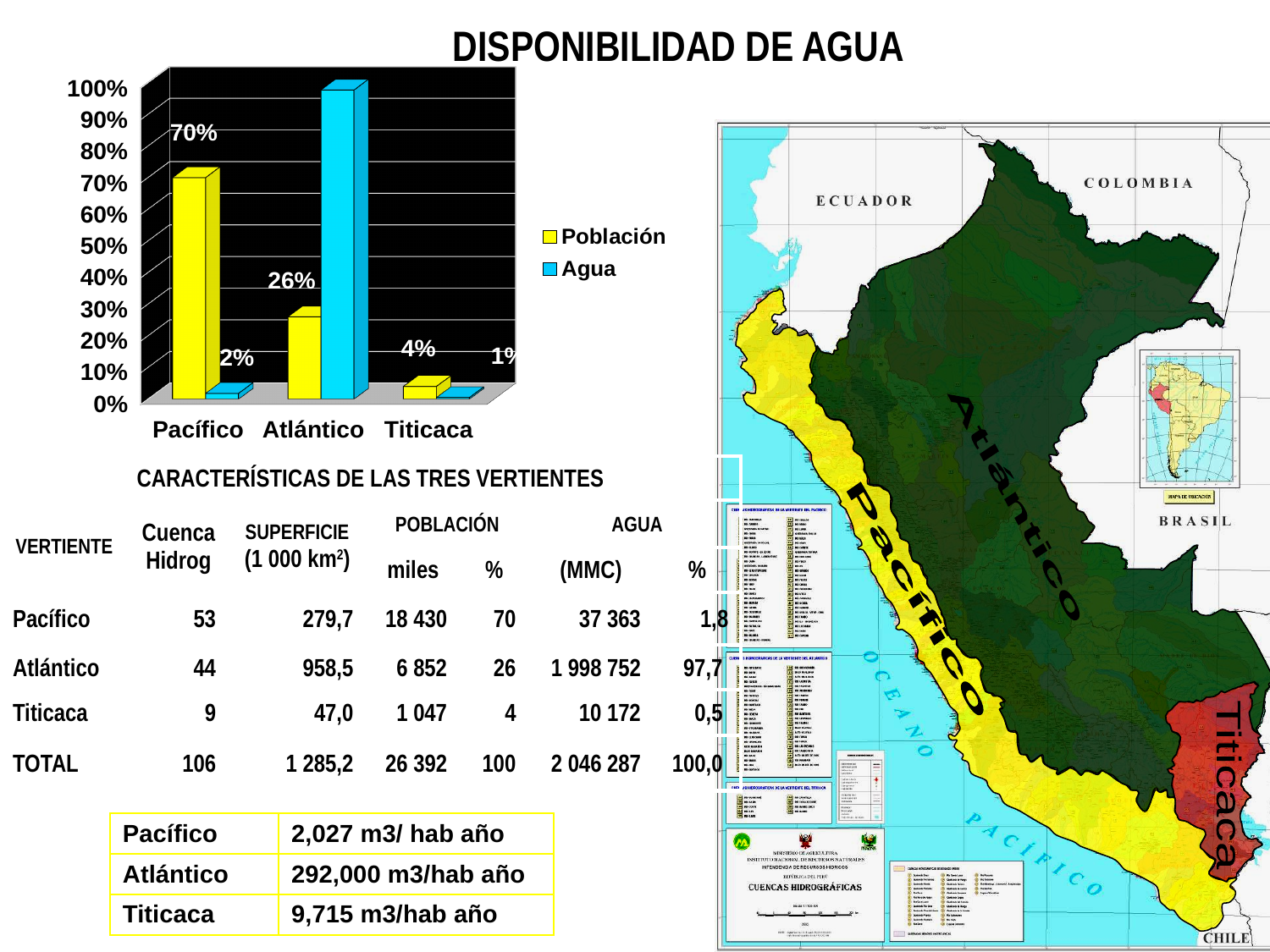
How many categories are shown on the x axis of the chart? 3 What kind of chart is shown on the slide? bar chart What is the Población value for Titicaca in the chart? 4% What is the difference between the Población values for Pacífico and Atlántico? 44% What is the Población value for Pacífico in the chart? 70% What is the Agua value for Pacífico in the chart? 2% How many series does the chart's legend list? 2 What is the Población value for Atlántico in the chart? 26% Which category has the highest Población value in the chart? Pacífico Is the Agua value for Atlántico greater or less than 90%? greater Which category has the lowest Población value in the chart? Titicaca Which category has the highest Agua value in the chart? Atlántico